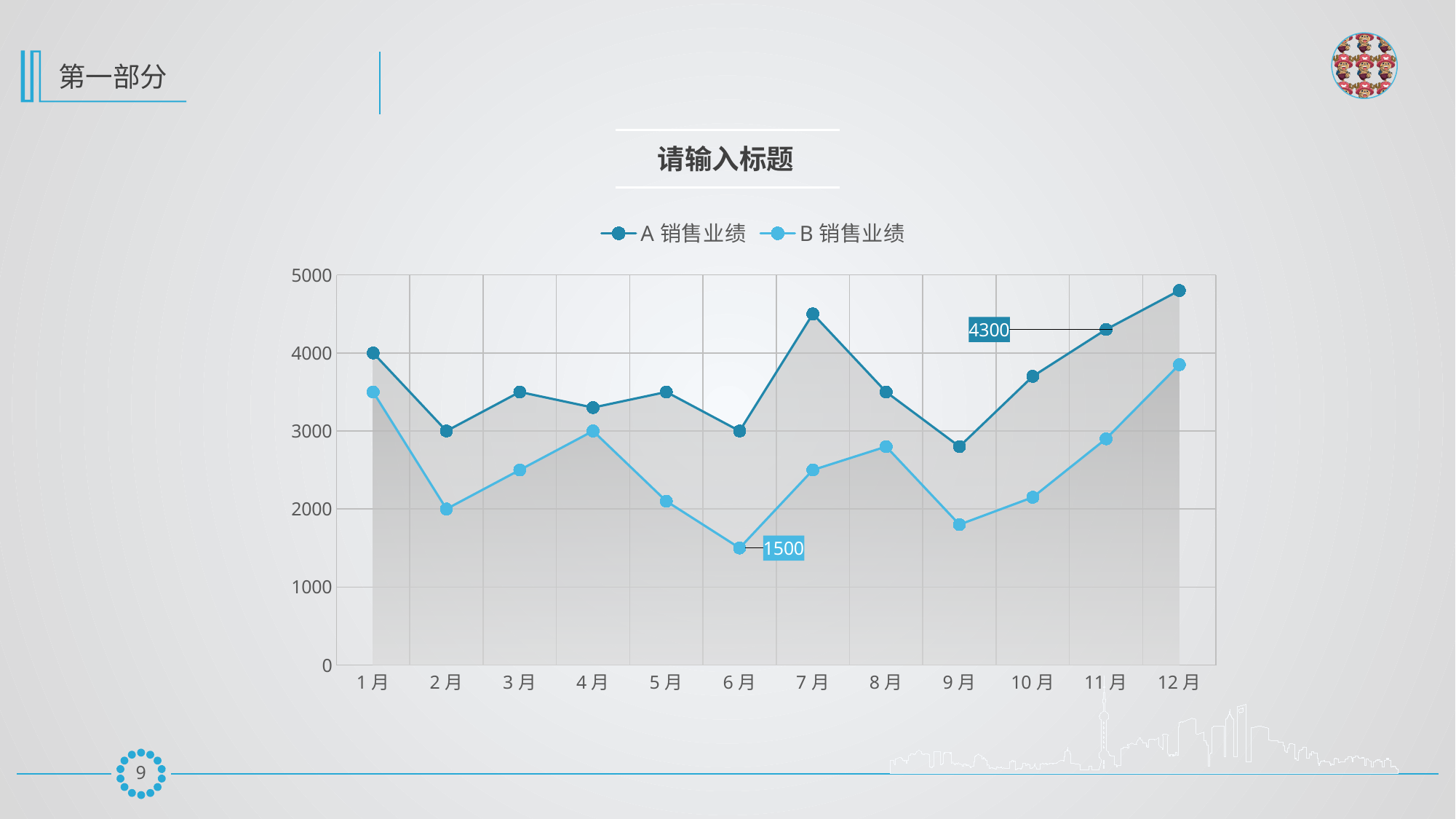
What is the value of A 销售业绩 in 11月? 4300 In which month does A 销售业绩 reach its highest value? 12月 In which month does B 销售业绩 reach its lowest value? 6月 What is the value of A 销售业绩 in 1月? 4000 Is the value for B 销售业绩 in 9月 greater or less than 2000? less How many series does the legend list? 2 What kind of chart is shown on the slide? Line chart Do the values of B 销售业绩 rise or fall from 9月 to 12月? rise Is the value for A 销售业绩 in 7月 greater or less than 4000? greater How many months are shown on the x axis? 12 What is the value of B 销售业绩 in 6月? 1500 In 6月, which series has the larger value, A 销售业绩 or B 销售业绩? A 销售业绩